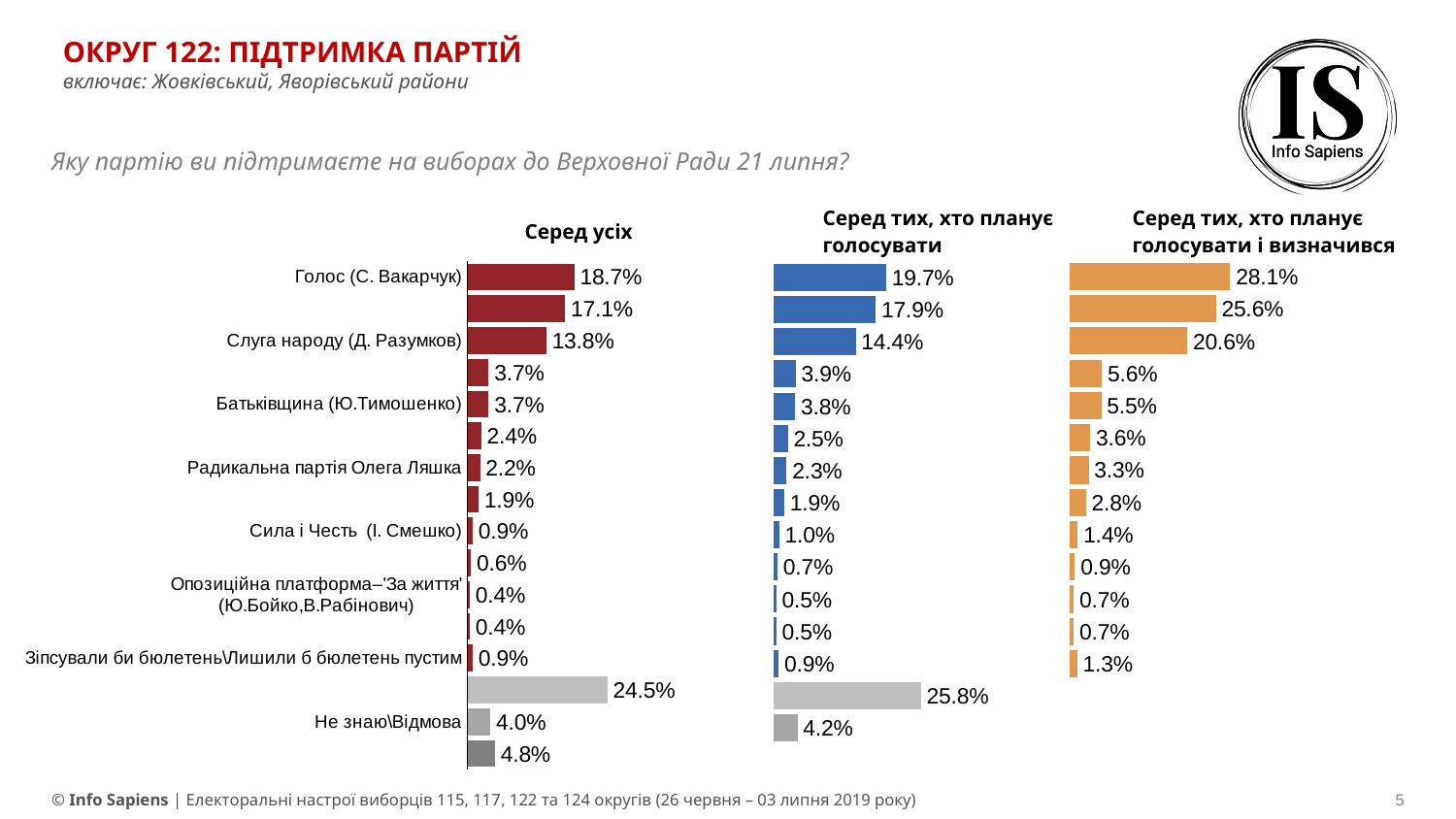
In the 'Серед усіх' chart, what is the difference between the values for Голос (С. Вакарчук) and Слуга народу (Д. Разумков)? 4.9% In the 'Серед тих, хто планує голосувати і визначився' chart, what is the value for Слуга народу (Д. Разумков)? 20.6% In the 'Серед тих, хто планує голосувати' chart, which is larger: the value for Сила і Честь (І. Смешко) or the value for Радикальна партія Олега Ляшка? Радикальна партія Олега Ляшка In the 'Серед усіх' chart, what is the value for Радикальна партія Олега Ляшка? 2.2% In the 'Серед усіх' chart, what is the value for Не знаю\Відмова? 4.0% What is the title of the chart on the left? Серед усіх In the 'Серед усіх' chart, what is the value for Голос (С. Вакарчук)? 18.7% In the 'Серед тих, хто планує голосувати' chart, what is the value for Зіпсували би бюлетень\Лишили б бюлетень пустим? 0.9% In the 'Серед тих, хто планує голосувати і визначився' chart, which party has the highest value? Голос (С. Вакарчук) In the 'Серед тих, хто планує голосувати' chart, what is the value for Батьківщина (Ю.Тимошенко)? 3.8% What type of chart is used on this slide? Bar chart How many separate charts are shown on the slide? 3